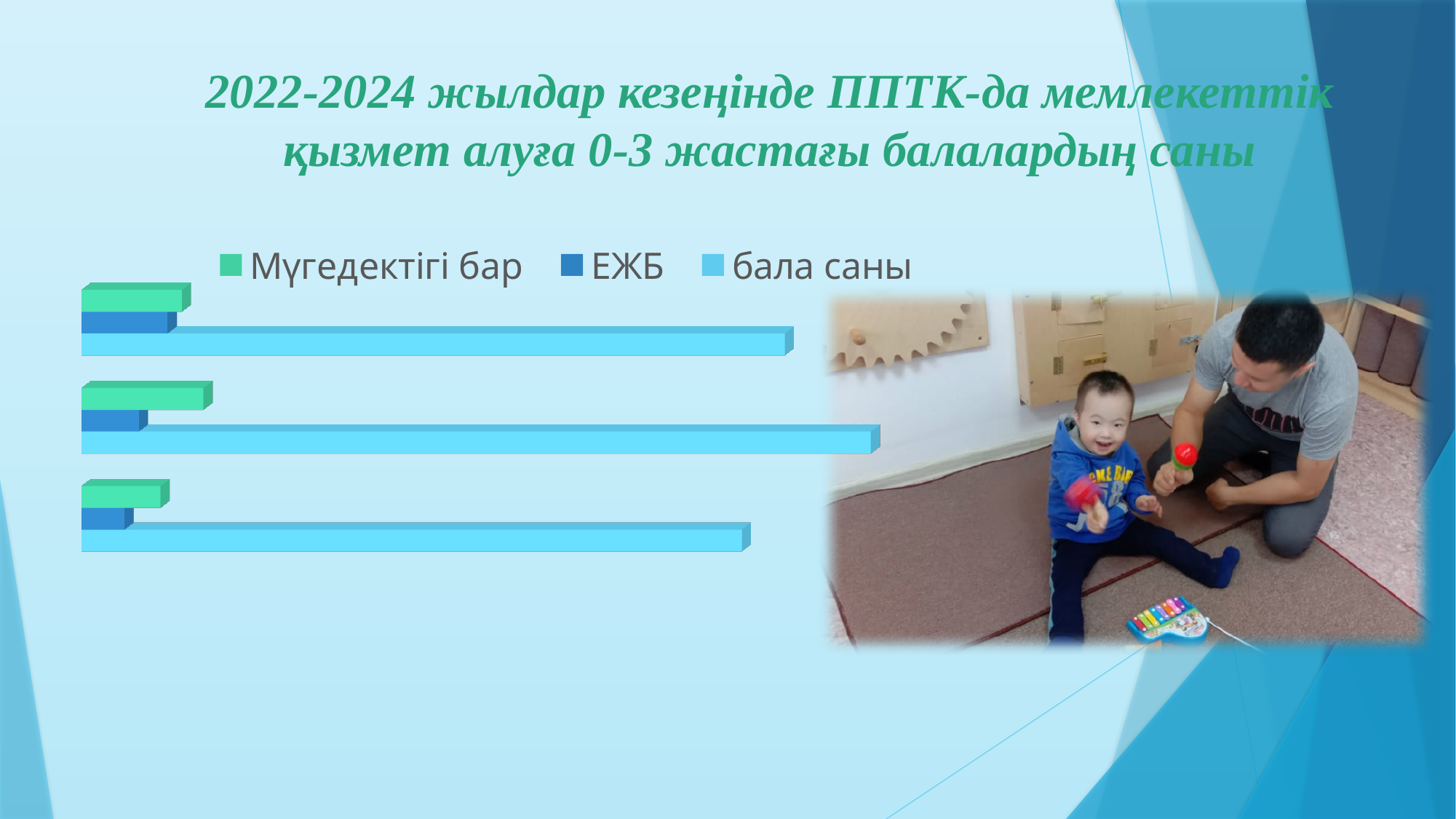
What kind of chart is shown on the slide? bar chart Which series is shown in green in the chart legend? Мүгедектігі бар In the middle group of bars, which is larger: бала саны or ЕЖБ? бала саны Are the bars in the chart drawn horizontally or vertically? horizontally How many groups of bars are plotted in the chart? 3 In the top group of bars, which is larger: Мүгедектігі бар or ЕЖБ? Мүгедектігі бар Which group of bars (top, middle or bottom) has the shortest бала саны bar? bottom How many series does the chart legend list? 3 Which series has the shortest bar in every group of the chart? ЕЖБ Which series is shown in light blue in the chart legend? бала саны Which group of bars (top, middle or bottom) has the longest бала саны bar? middle Which series has the longest bar in every group of the chart? бала саны